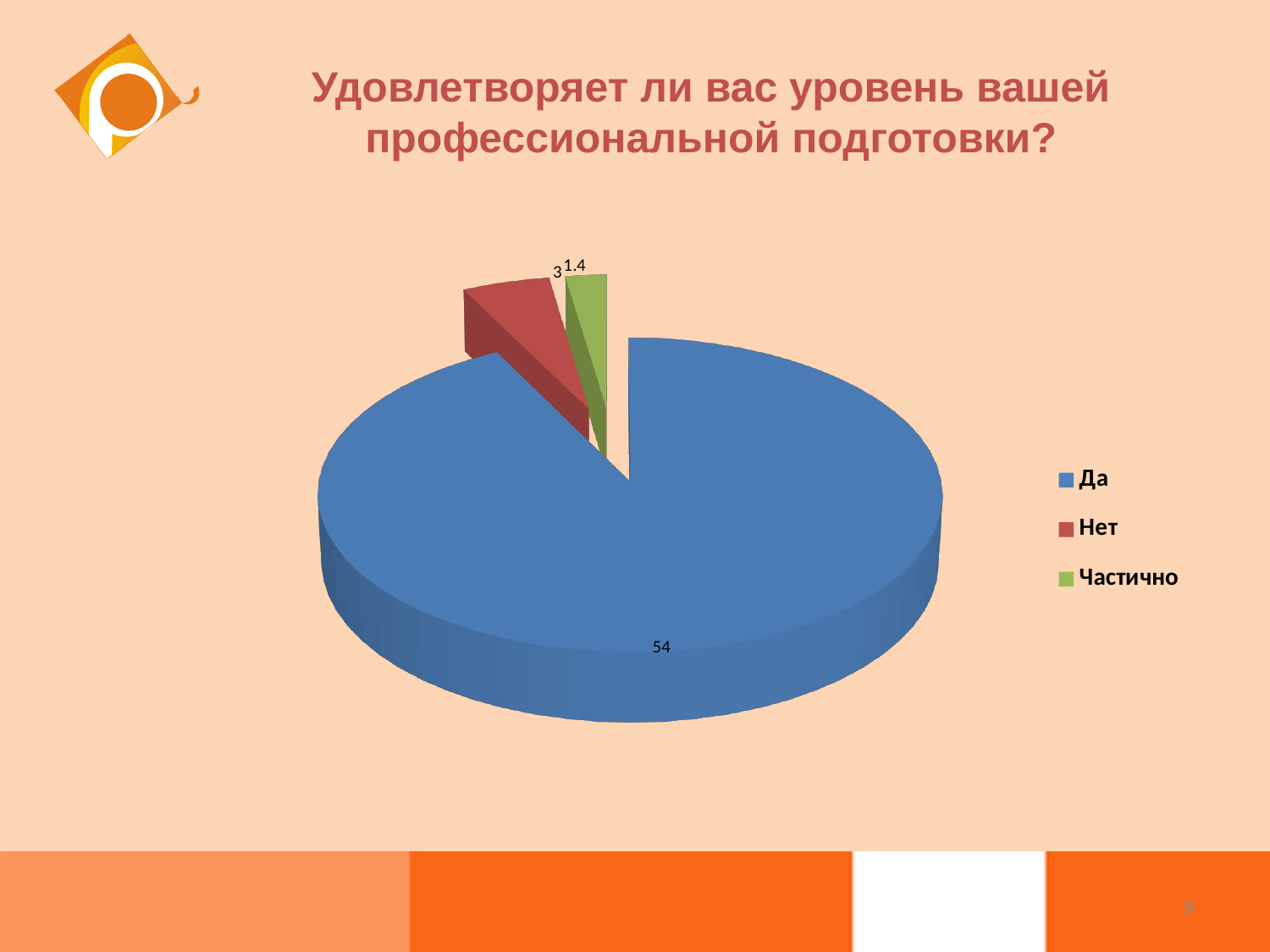
Which category has the smallest slice? Частично What type of chart is shown on the slide? Pie chart What is the value for the "Нет" slice? 3 How many slices does the pie chart have? 3 What is the difference between the values for "Да" and "Нет"? 51 What colour is the "Да" slice? Blue Which is larger, the value for "Нет" or the value for "Частично"? Нет What is the value for the "Да" slice? 54 Which category has the largest slice? Да What is the difference between the values for "Нет" and "Частично"? 1.6 What is the value for the "Частично" slice? 1.4 How many entries does the legend list? 3